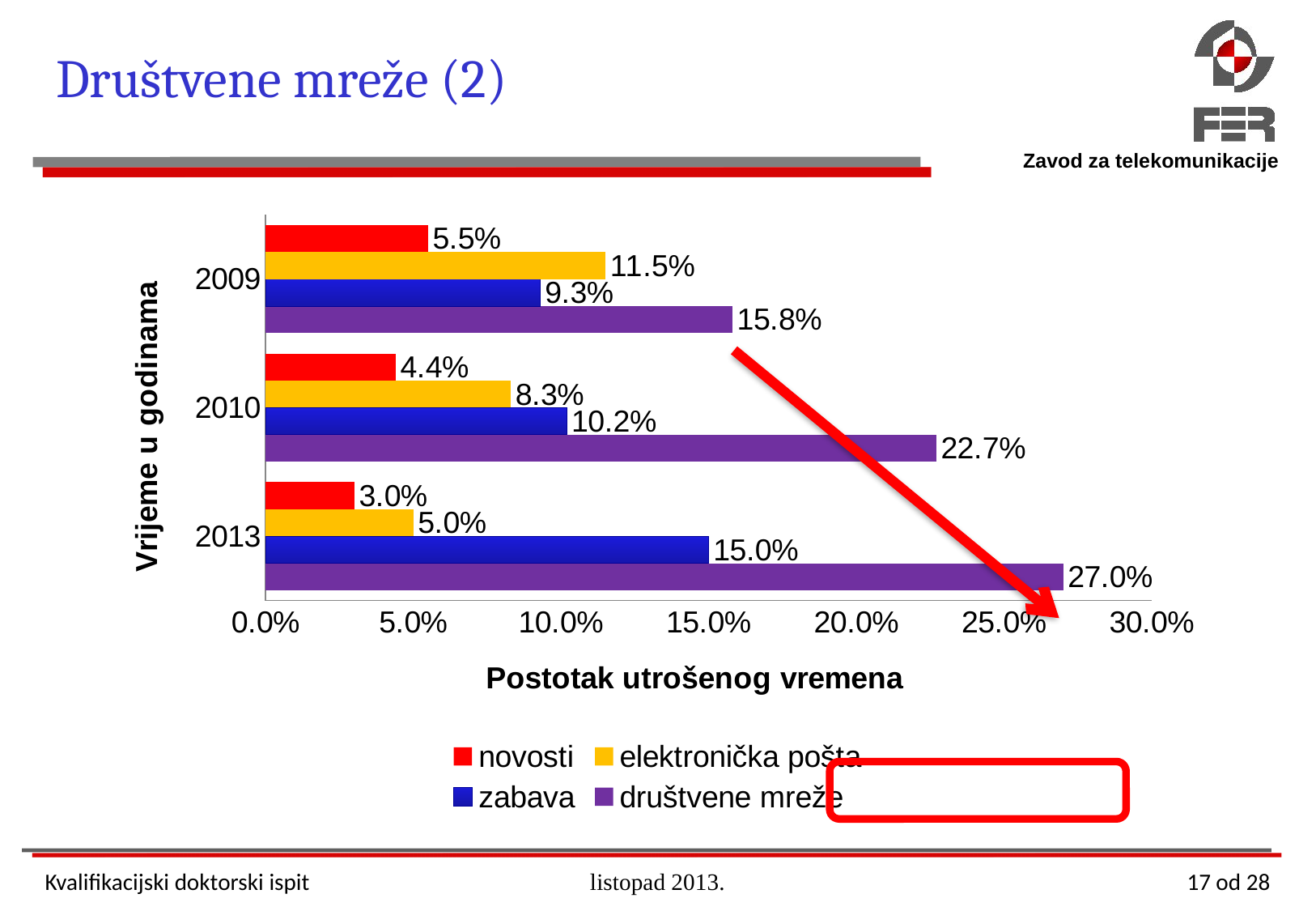
How many years are shown on the y axis? 3 In which year is the value for novosti lowest? 2013 What is the value for zabava in 2010? 10.2% What is the difference between the društvene mreže values for 2013 and 2009? 11.2% What is the label of the x axis? Postotak utrošenog vremena What is the value for društvene mreže in 2013? 27.0% How many series does the legend list? 4 In which year is the value for društvene mreže highest? 2013 What kind of chart is shown on the slide? bar chart Which is larger in 2010: elektronička pošta or zabava? zabava What is the value for novosti in 2013? 3.0% What is the value for elektronička pošta in 2009? 11.5%